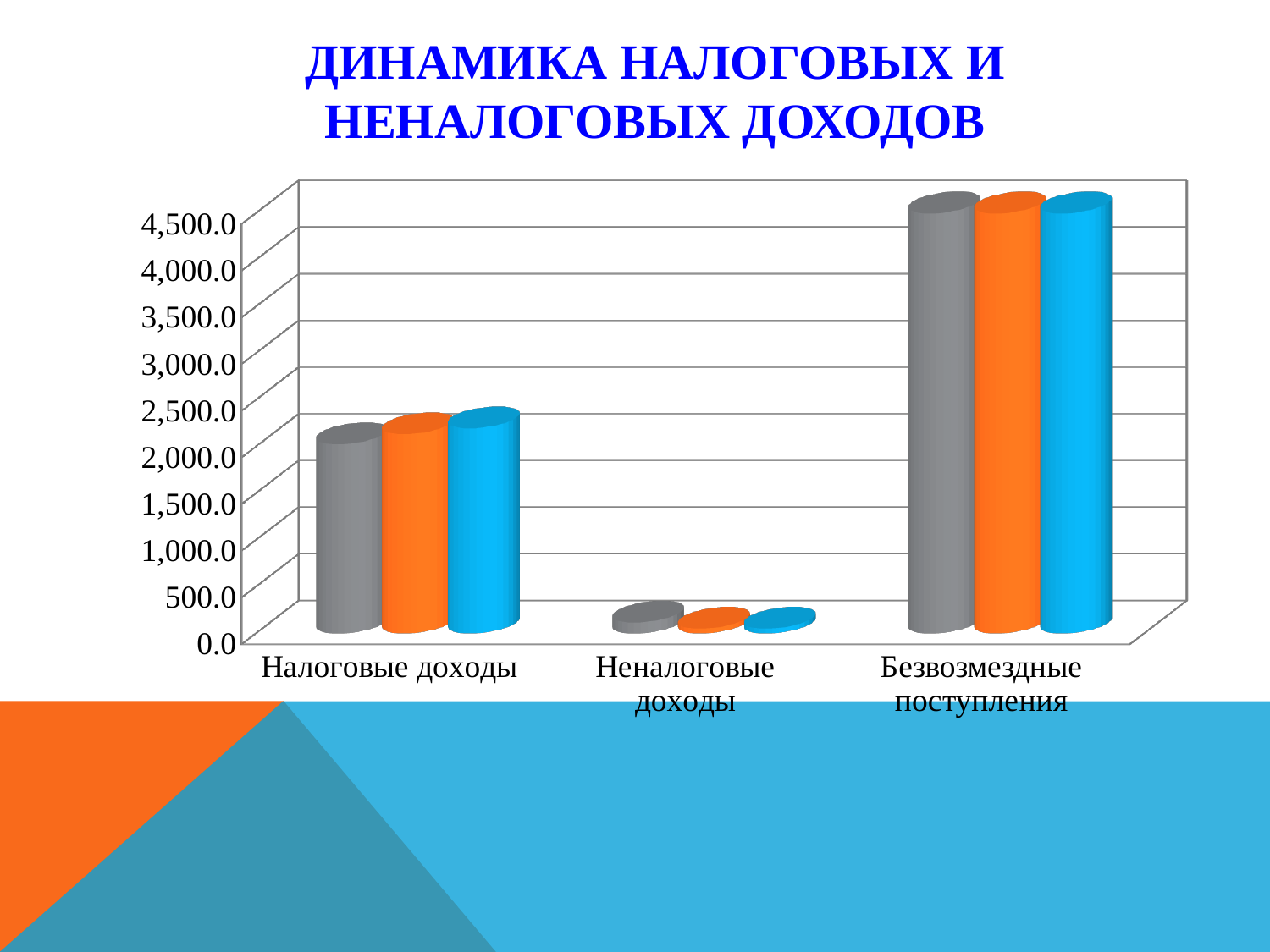
Are the bars for Неналоговые доходы greater or less than 500.0? less What kind of chart is shown on the slide? bar chart Are the bars for Налоговые доходы greater or less than 3,000.0? less How many categories are shown on the x axis of the chart? 3 Which category has the highest bars in the chart? Безвозмездные поступления Which category has the lowest bars in the chart? Неналоговые доходы How many bars are shown for each category in the chart? 3 Which category has larger values, Налоговые доходы or Безвозмездные поступления? Безвозмездные поступления Which category has larger values, Неналоговые доходы or Налоговые доходы? Налоговые доходы What is the title of the slide containing the chart? ДИНАМИКА НАЛОГОВЫХ И НЕНАЛОГОВЫХ ДОХОДОВ Are the bars for Безвозмездные поступления greater or less than 4,000.0? greater